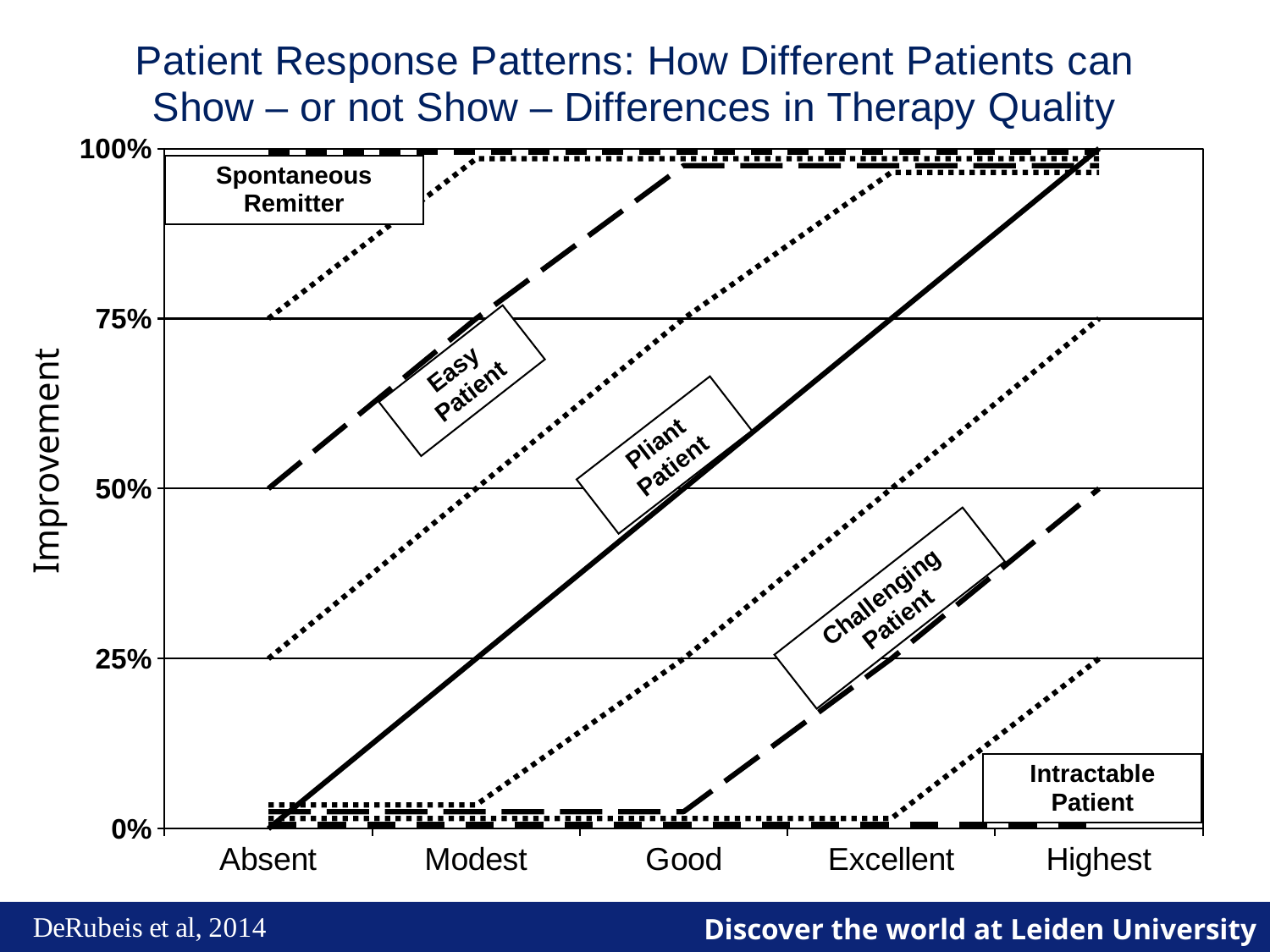
Is the Improvement value for the Spontaneous Remitter at Good greater or less than 75%? greater What is the title of the y axis of the chart? Improvement At Modest, which line is higher: Easy Patient or Challenging Patient? Easy Patient What kind of chart is shown on the slide? line chart Is the Improvement value for the Easy Patient at Modest greater or less than 50%? greater Is the Improvement value for the Challenging Patient at Excellent greater or less than 50%? less How many categories are shown on the x axis of the chart? 5 Does the Pliant Patient line rise or fall from Absent to Highest? rise Does the Intractable Patient line rise, fall, or stay flat between Absent and Excellent? stay flat What is the Improvement value for the Pliant Patient at Good? 50% What are the categories listed along the x axis, from left to right? Absent, Modest, Good, Excellent, Highest